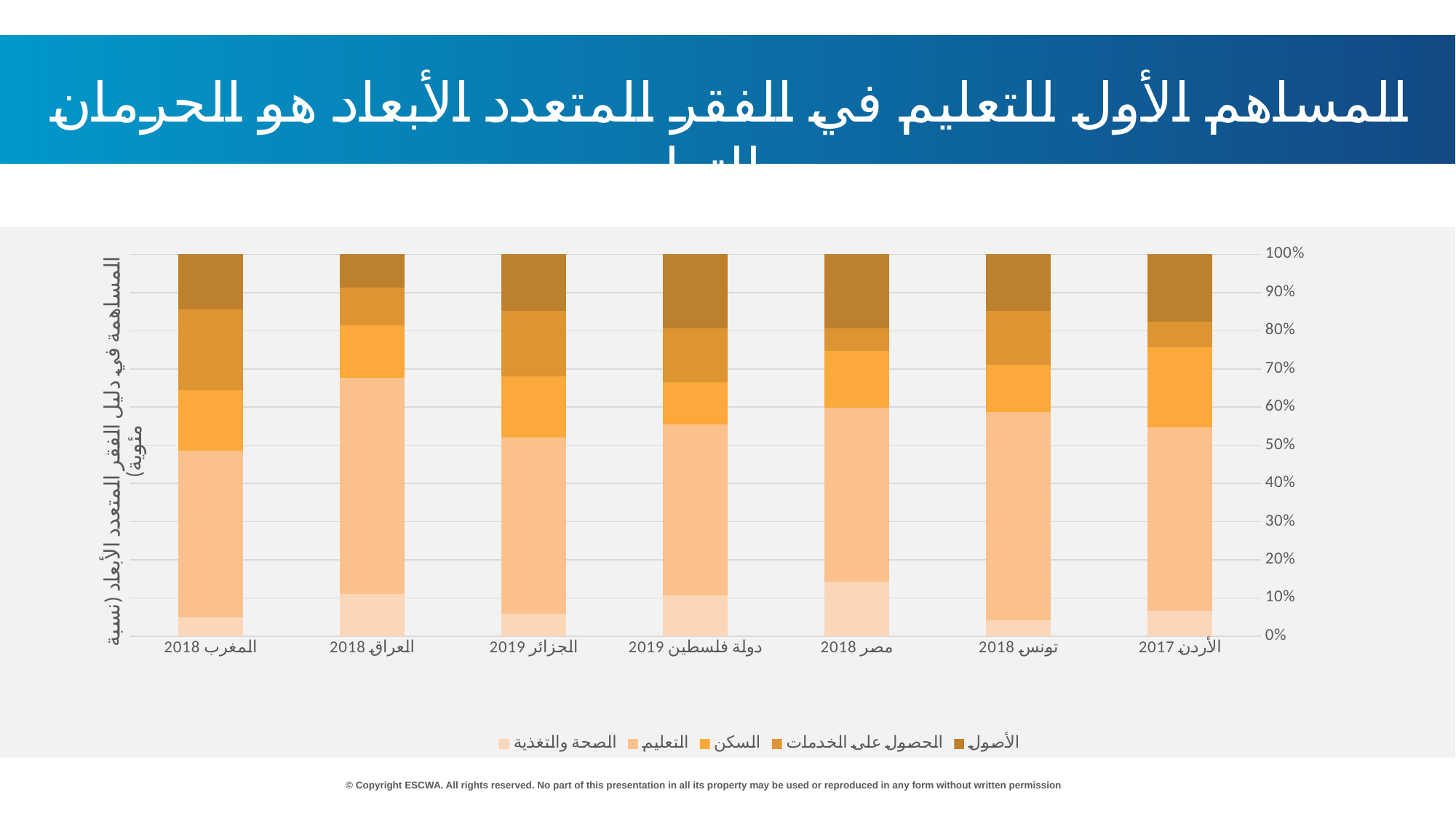
Is the الصحة والتغذية segment for مصر 2018 greater or less than 10%? greater Which category is shown at the far right of the x axis? الأردن 2017 What is the highest value shown on the vertical axis of the chart? 100% Which category has the largest الصحة والتغذية segment? مصر 2018 Is the الصحة والتغذية segment for تونس 2018 greater or less than 10%? less How many series does the chart legend list? 5 Is the الصحة والتغذية segment for المغرب 2018 greater or less than 10%? less How many country-year categories are shown on the x axis of the chart? 7 What is the total height of the stacked bar for المغرب 2018? 100% What kind of chart is shown on the slide? Stacked bar chart Which series is listed first (rightmost) in the chart legend? الأصول Which has the larger الصحة والتغذية segment, مصر 2018 or تونس 2018? مصر 2018